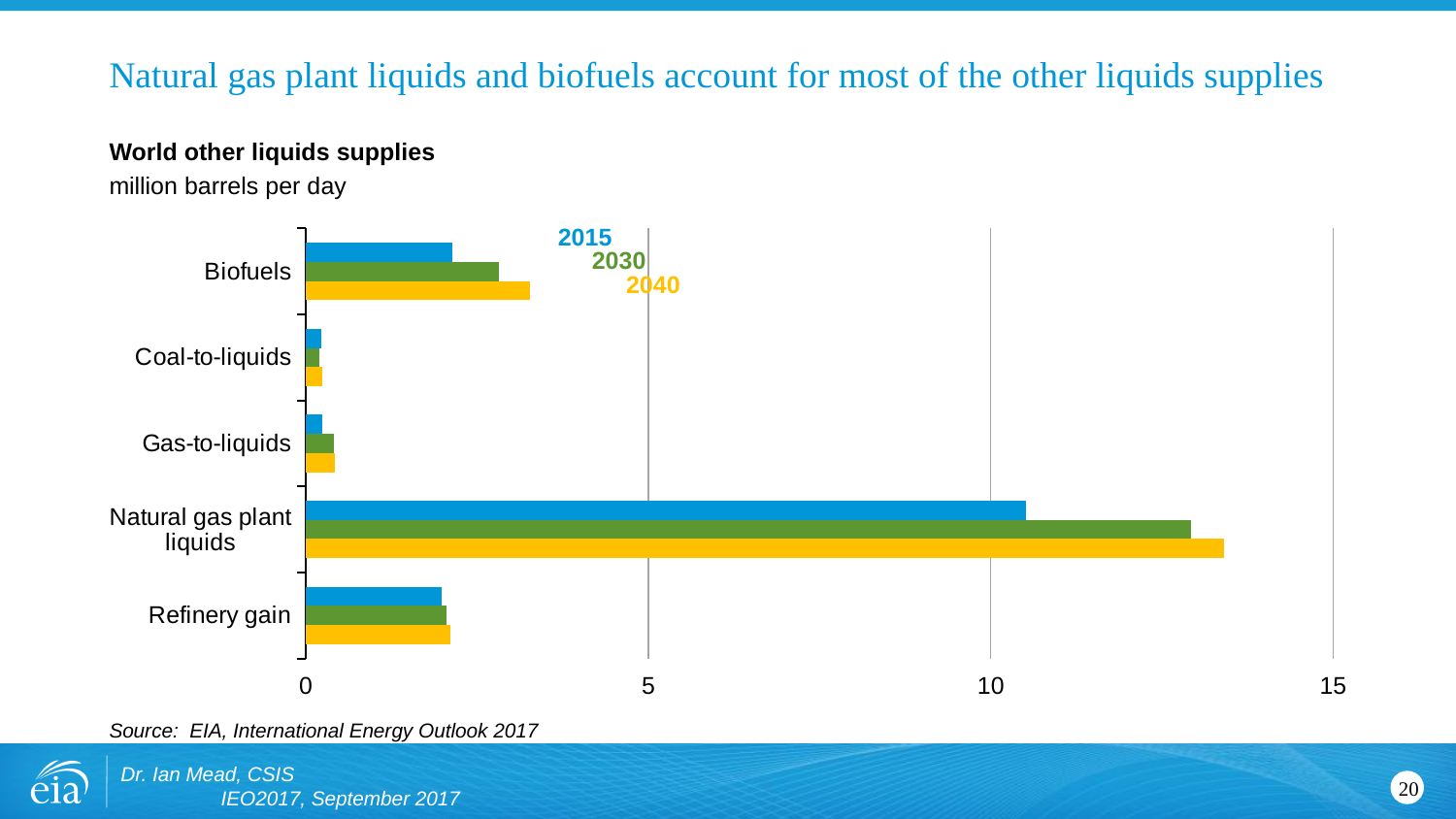
Is the 2040 value for Natural gas plant liquids greater or less than 15? less Which category has the lowest value for 2040? Coal-to-liquids Is the 2015 value for Natural gas plant liquids greater or less than 10? greater Is the 2040 value for Biofuels greater or less than 5? less What is the title of the chart? World other liquids supplies Which category has the highest value for 2040? Natural gas plant liquids What kind of chart is shown on the slide? bar chart What unit is the chart measured in? million barrels per day Which is larger for 2040: Biofuels or Refinery gain? Biofuels How many categories are plotted on the chart? 5 For Natural gas plant liquids, which is larger: the 2015 value or the 2030 value? 2030 How many series does the chart's legend list? 3